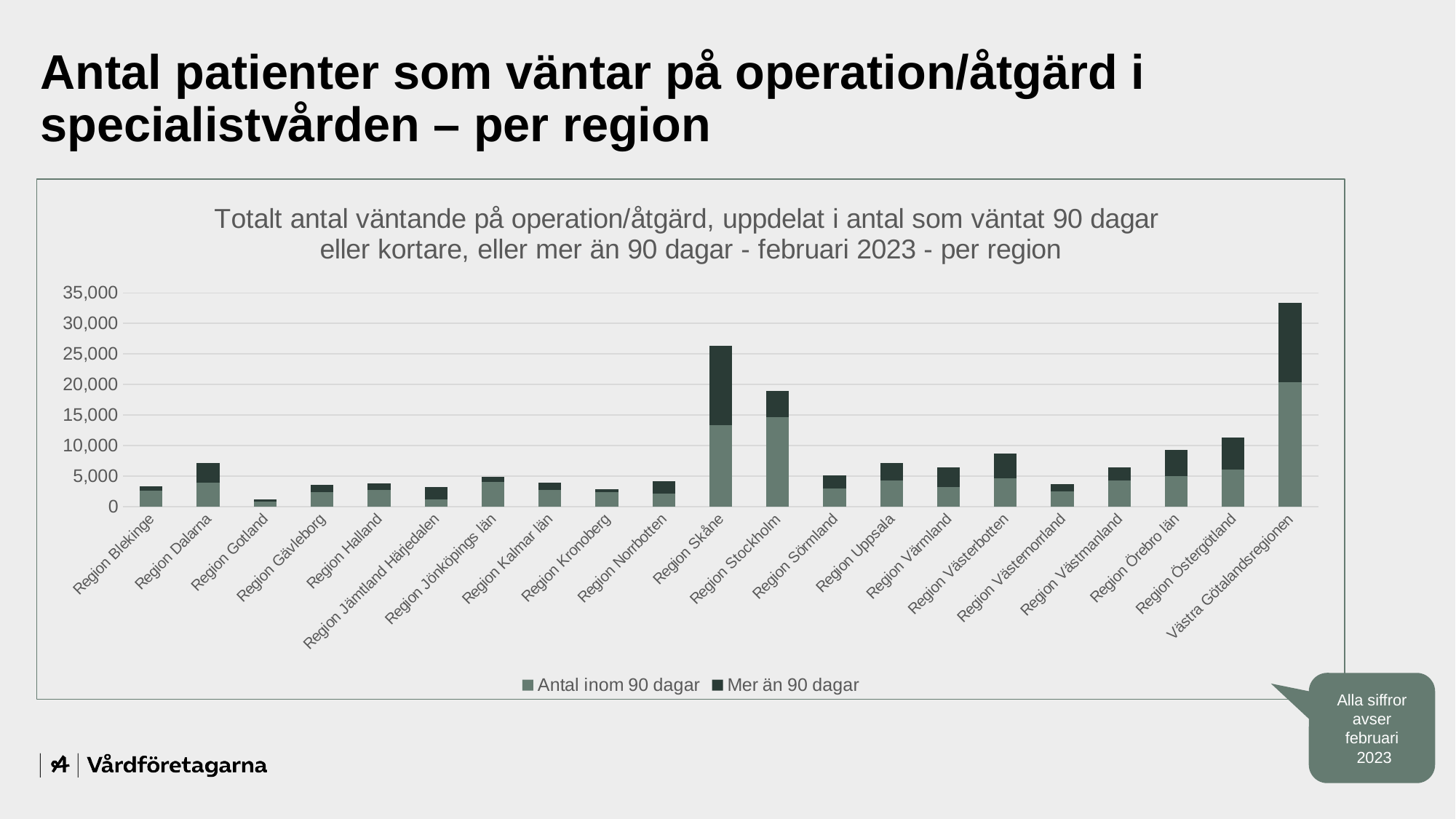
How many series does the chart's legend list? 2 Is the total value for Västra Götalandsregionen greater or less than 30,000? greater Which has a larger total number of patients waiting, Region Skåne or Region Stockholm? Region Skåne What are the two series named in the chart's legend? Antal inom 90 dagar; Mer än 90 dagar Which region has the highest total number of patients waiting? Västra Götalandsregionen Which has a larger total number of patients waiting, Region Dalarna or Region Blekinge? Region Dalarna Is the total value for Region Östergötland greater or less than 10,000? greater What kind of chart is shown on the slide? Stacked bar chart Is the total value for Region Skåne greater or less than 25,000? greater Which region has the lowest total number of patients waiting? Region Gotland How many regions are shown on the x axis of the chart? 21